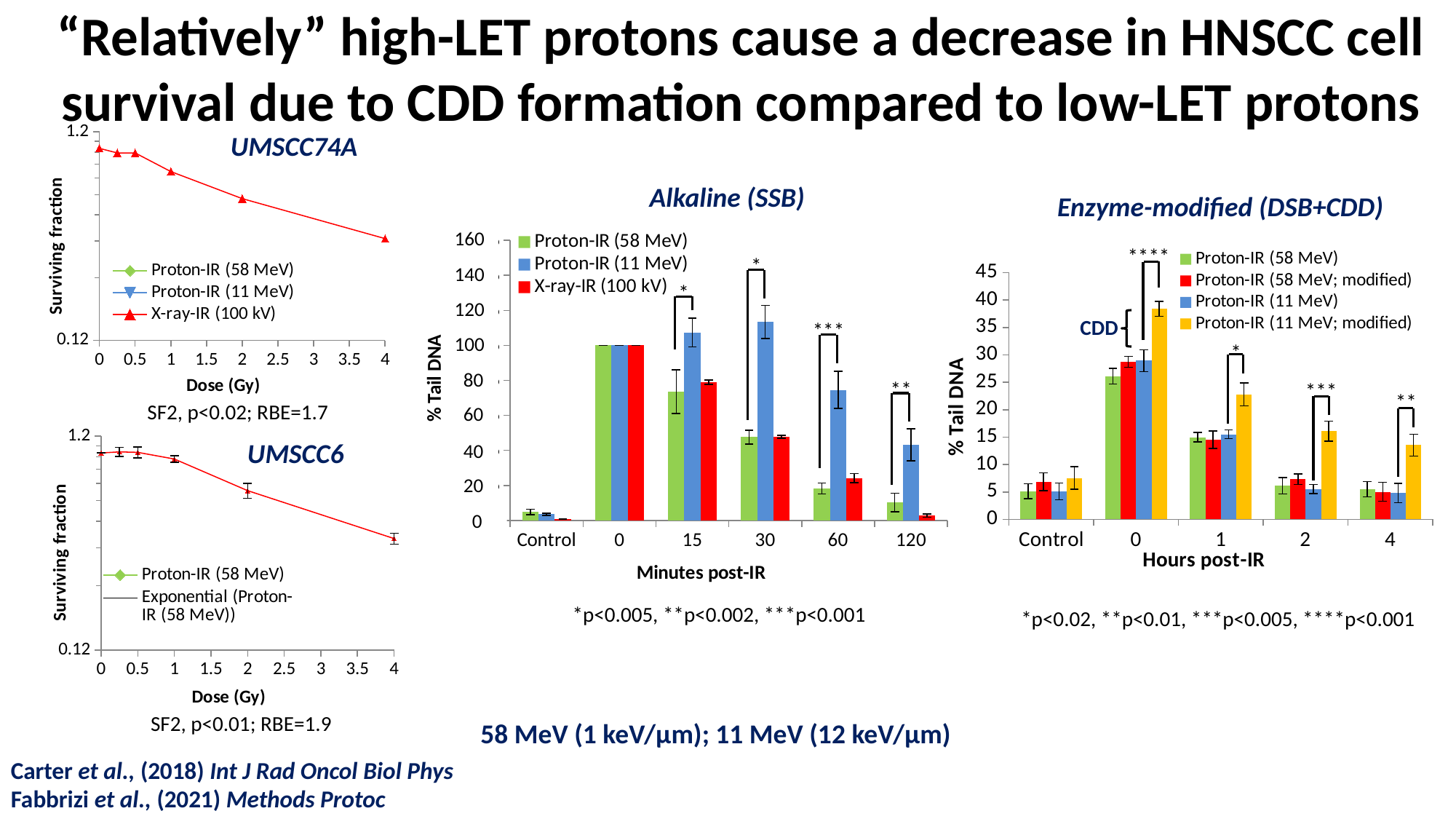
In the Alkaline (SSB) chart, what is the % Tail DNA for Proton-IR (58 MeV) at 0 minutes post-IR? 100 In the Alkaline (SSB) chart, is the value for Proton-IR (11 MeV) at 30 minutes post-IR greater or less than 100? greater How many series does the legend of the Enzyme-modified (DSB+CDD) chart list? 4 How many series does the legend of the Alkaline (SSB) chart list? 3 In the Enzyme-modified (DSB+CDD) chart, at 1 hour post-IR, which is larger: Proton-IR (11 MeV; modified) or Proton-IR (58 MeV)? Proton-IR (11 MeV; modified) What kind of chart is the UMSCC74A chart at the top left? line chart In the Alkaline (SSB) chart, does the Proton-IR (58 MeV) series rise or fall from 0 to 120 minutes post-IR? fall How many categories are shown on the x axis of the Alkaline (SSB) chart? 6 In the Alkaline (SSB) chart, which series has the highest value at 15 minutes post-IR? Proton-IR (11 MeV) How many categories are shown on the x axis of the Enzyme-modified (DSB+CDD) chart? 5 In the Enzyme-modified (DSB+CDD) chart, which series has the highest value at 0 hours post-IR? Proton-IR (11 MeV; modified) What kind of chart is the Alkaline (SSB) chart? bar chart